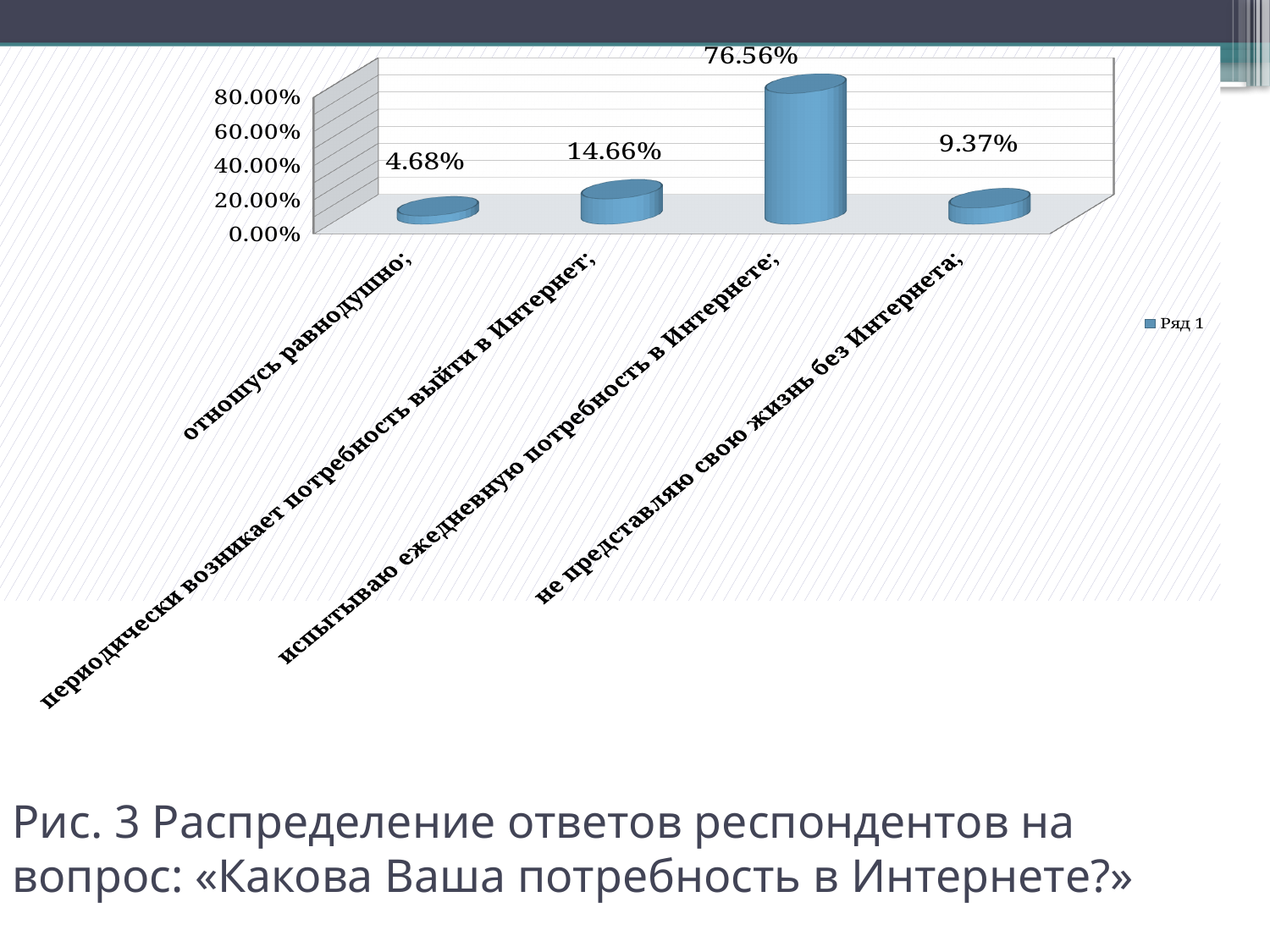
What series name is listed in the legend? Ряд 1 Is the value for "испытываю ежедневную потребность в Интернете" greater or less than 60.00%? greater Which category has the lowest value? отношусь равнодушно What is the difference between the values for "испытываю ежедневную потребность в Интернете" and "периодически возникает потребность выйти в Интернет"? 61.90% Which is larger: the value for "не представляю свою жизнь без Интернета" or for "периодически возникает потребность выйти в Интернет"? периодически возникает потребность выйти в Интернет What is the value for "не представляю свою жизнь без Интернета"? 9.37% What is the value for "испытываю ежедневную потребность в Интернете"? 76.56% Which category has the highest value? испытываю ежедневную потребность в Интернете What is the value for "периодически возникает потребность выйти в Интернет"? 14.66% What is the value for "отношусь равнодушно"? 4.68% What kind of chart is shown on the slide? bar chart How many categories are shown in the chart? 4